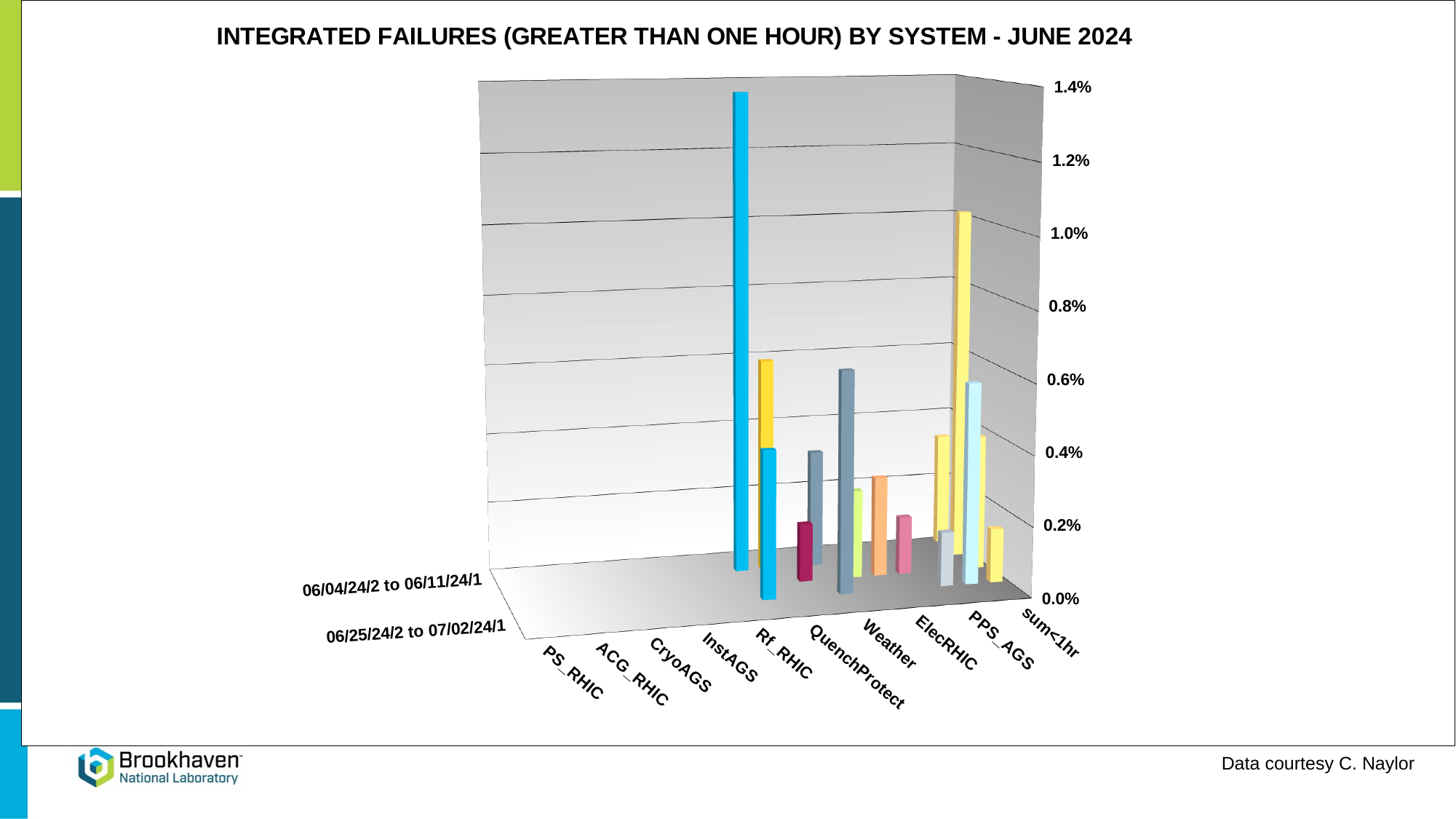
How many system categories are shown along the x axis of the chart? 10 Is the tallest bar in the chart greater or less than 1.2%? greater What is the title of the chart? INTEGRATED FAILURES (GREATER THAN ONE HOUR) BY SYSTEM - JUNE 2024 What kind of chart is shown on the slide? bar chart Which date range contains the tallest bar in the chart? 06/04/24/2 to 06/11/24/1 What is the highest value shown on the vertical axis of the chart? 1.4% How many date ranges (rows of bars) does the chart show? 2